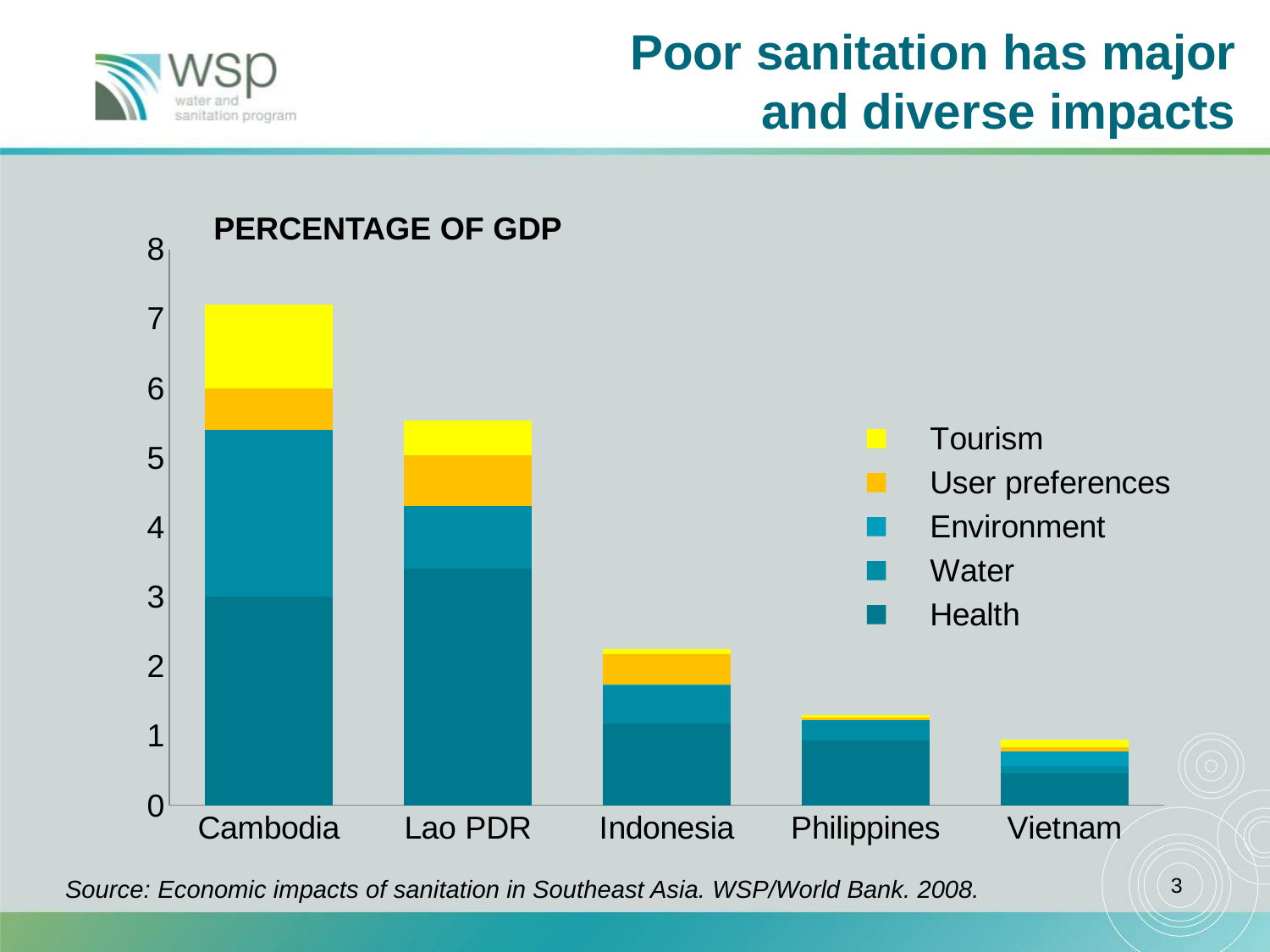
How many series does the chart's legend list? 5 Is the total value for Indonesia greater or less than 3? less What is the title of the chart? PERCENTAGE OF GDP Which country has the lowest total percentage of GDP in the chart? Vietnam Is the total value for Lao PDR greater or less than 5? greater What kind of chart is shown on the slide? bar chart Which country has the highest total percentage of GDP in the chart? Cambodia Which has a larger total bar, Lao PDR or Indonesia? Lao PDR Do the total bar heights rise or fall from left to right across the countries? fall Is the total value for Cambodia greater or less than 7? greater How many countries are shown on the x axis of the chart? 5